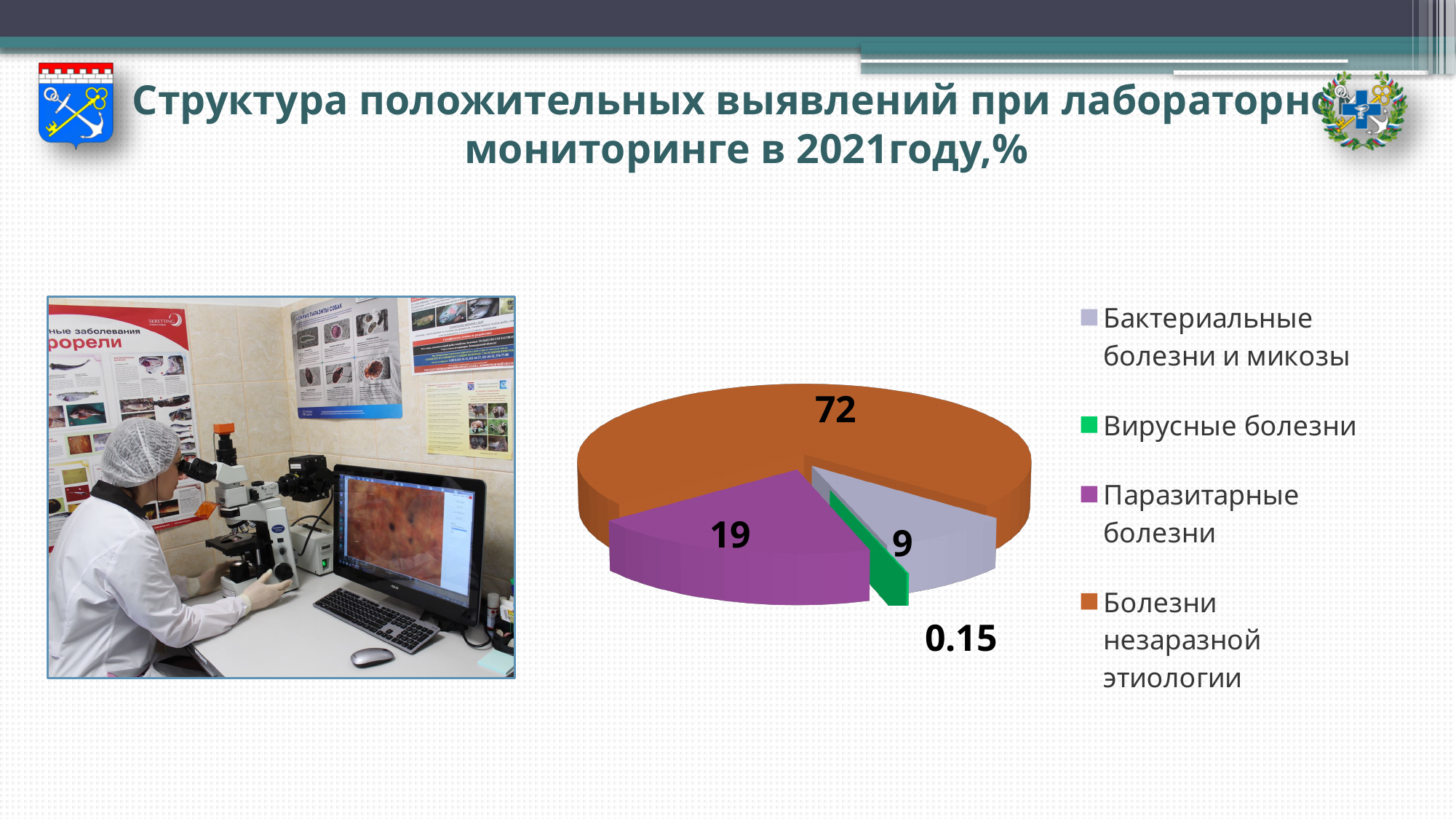
Which is larger, the value for Паразитарные болезни or the value for Бактериальные болезни и микозы? Паразитарные болезни How many categories does the pie chart show? 4 What year does the chart title refer to? 2021 What is the difference between the values for Болезни незаразной этиологии and Паразитарные болезни? 53 Which category has the smallest slice of the pie? Вирусные болезни What is the value for Болезни незаразной этиологии? 72 What colour is the slice for Паразитарные болезни? Purple What is the value for Паразитарные болезни? 19 What is the value for Бактериальные болезни и микозы? 9 Which category has the largest slice of the pie? Болезни незаразной этиологии What kind of chart is shown on the slide? Pie chart What is the value for Вирусные болезни? 0.15